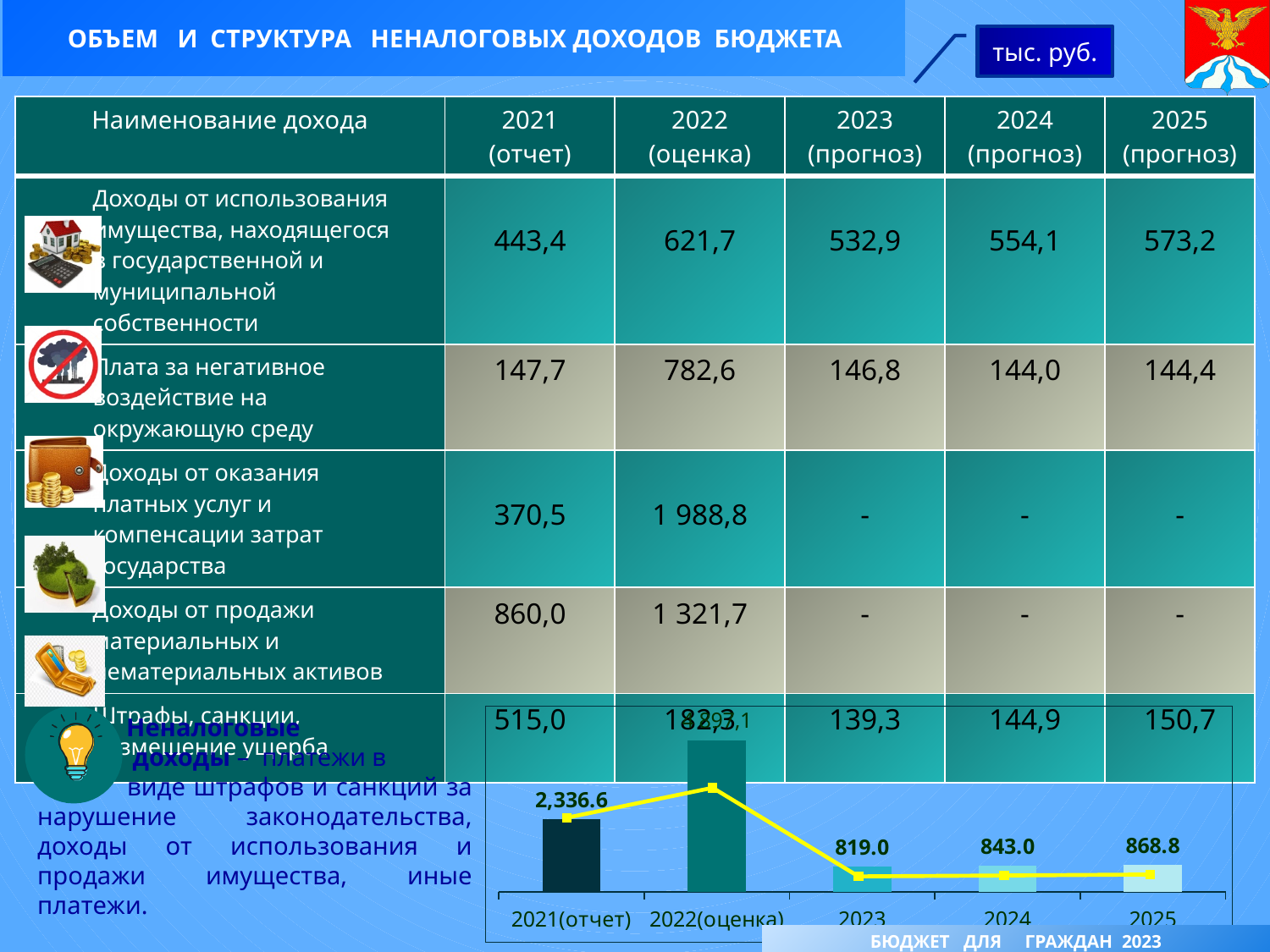
In the chart at the bottom of the slide, what is the value for 2025? 868.8 In the chart at the bottom of the slide, which year has the highest value? 2022(оценка) In the chart at the bottom of the slide, what is the value for 2021(отчет)? 2,336.6 In the chart at the bottom of the slide, what is the value for 2024? 843.0 In the chart at the bottom of the slide, how many years are shown on the x axis? 5 In the chart at the bottom of the slide, do the values rise or fall from 2023 to 2025? rise In the chart at the bottom of the slide, what is the difference between the values for 2021(отчет) and 2023? 1,517.6 In the chart at the bottom of the slide, which is larger: the value for 2024 or the value for 2025? 2025 In the chart at the bottom of the slide, what is the difference between the values for 2025 and 2023? 49.8 What kind of chart is shown at the bottom of the slide? bar chart with a line In the chart at the bottom of the slide, what is the value for 2023? 819.0 In the chart at the bottom of the slide, which year has the lowest value? 2023